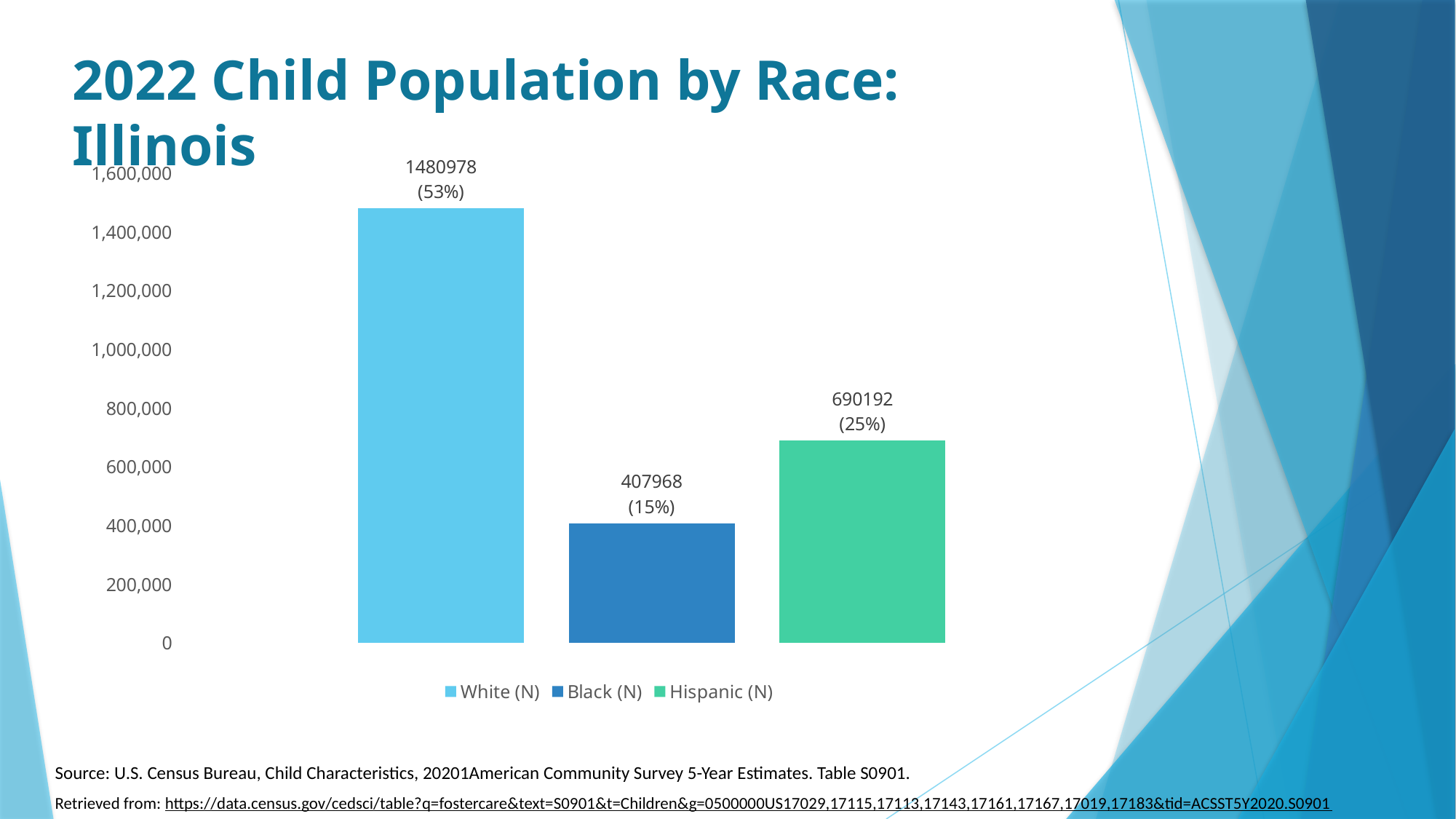
What is the value shown for Black (N)? 407968 Is the value for White (N) greater or less than 1,400,000? greater What percentage is shown for Hispanic (N)? 25% What is the value shown for White (N)? 1480978 How many entries does the legend list? 3 How many bars are plotted in the chart? 3 Which group has the highest child population? White (N) Which group has the lowest child population? Black (N) What kind of chart is shown on the slide? Bar chart What is the difference between the values for Hispanic (N) and Black (N)? 282224 Which is larger, the value for Hispanic (N) or the value for Black (N)? Hispanic (N) What is the difference between the values for White (N) and Hispanic (N)? 790786